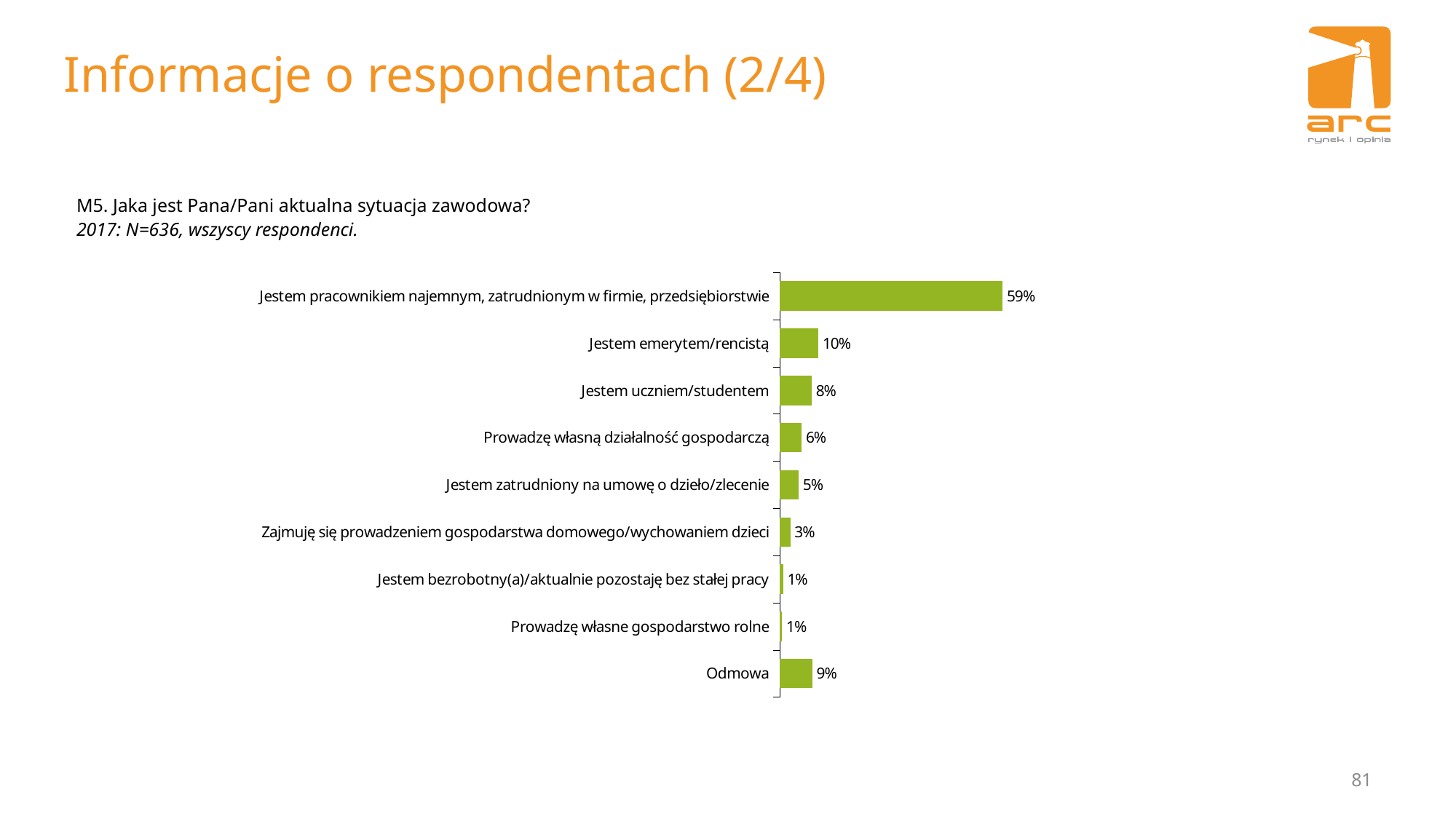
What is the sample size (N) stated for the 2017 survey on the slide? 636 How many categories are shown in the chart? 9 What is the value shown for "Zajmuję się prowadzeniem gospodarstwa domowego/wychowaniem dzieci"? 3% Which category has the highest value in the chart? Jestem pracownikiem najemnym, zatrudnionym w firmie, przedsiębiorstwie Which is larger: the value for "Jestem uczniem/studentem" or the value for "Odmowa"? Odmowa What kind of chart is shown on the slide? Bar chart What is the difference between the values for "Jestem uczniem/studentem" and "Prowadzę własną działalność gospodarczą"? 2% What is the difference between the values for "Jestem pracownikiem najemnym, zatrudnionym w firmie, przedsiębiorstwie" and "Jestem emerytem/rencistą"? 49% What percentage of respondents answered "Jestem pracownikiem najemnym, zatrudnionym w firmie, przedsiębiorstwie"? 59% What is the value shown for "Jestem emerytem/rencistą"? 10% Which is larger: the value for "Jestem zatrudniony na umowę o dzieło/zlecenie" or the value for "Prowadzę własną działalność gospodarczą"? Prowadzę własną działalność gospodarczą What is the value shown for "Odmowa"? 9%